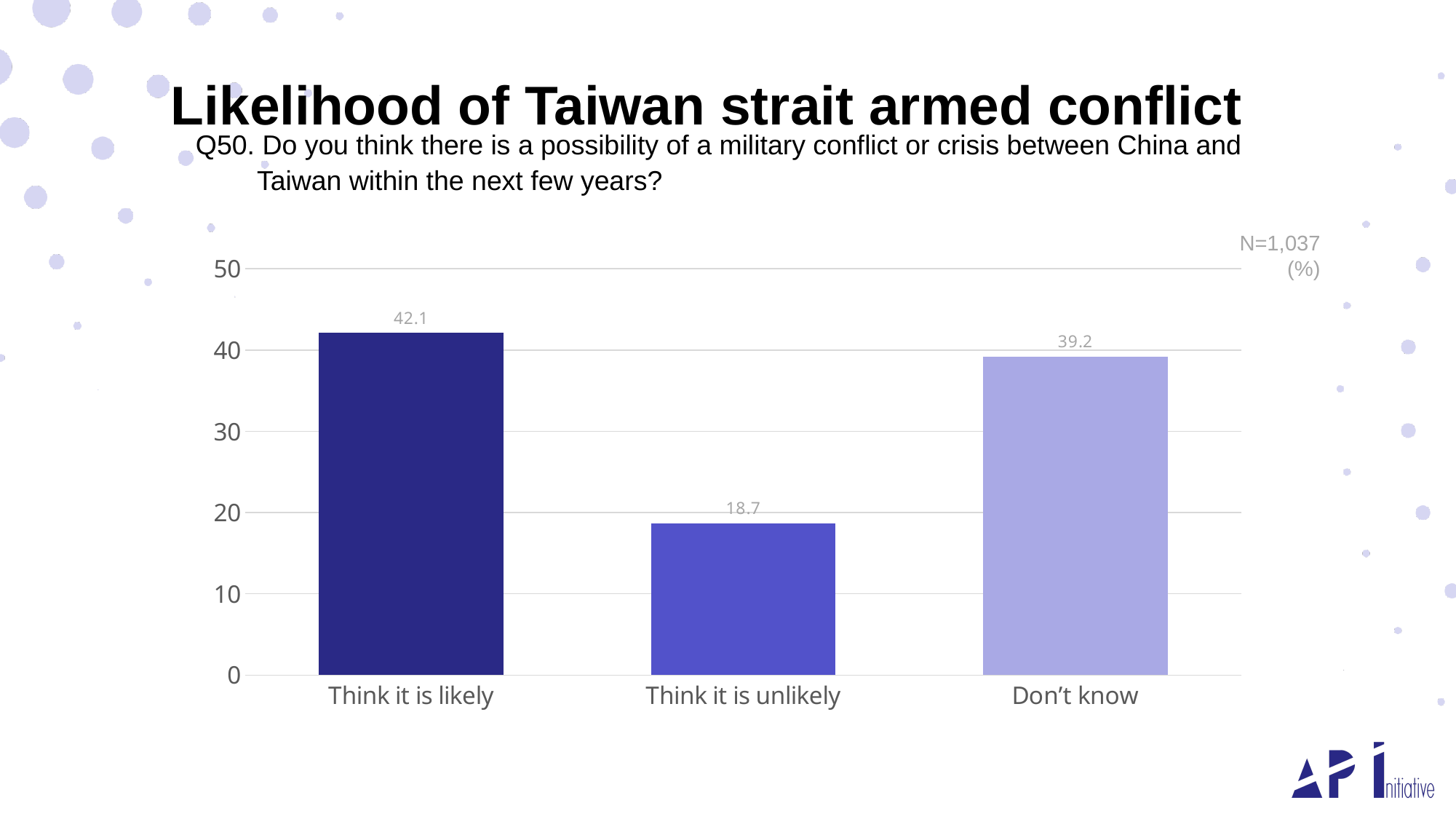
Which category has the lowest value? Think it is unlikely What is the value for "Think it is likely"? 42.1 How many categories are shown on the x axis? 3 Which is larger, the value for "Think it is unlikely" or the value for "Don't know"? Don't know Is the value for "Think it is unlikely" greater or less than 20? less What is the difference between the values for "Think it is likely" and "Don't know"? 2.9 What is the value for "Don't know"? 39.2 What is the value for "Think it is unlikely"? 18.7 What sample size (N) is shown on the chart? N=1,037 What is the difference between the values for "Don't know" and "Think it is unlikely"? 20.5 Which category has the highest value? Think it is likely What kind of chart is shown on the slide? Bar chart